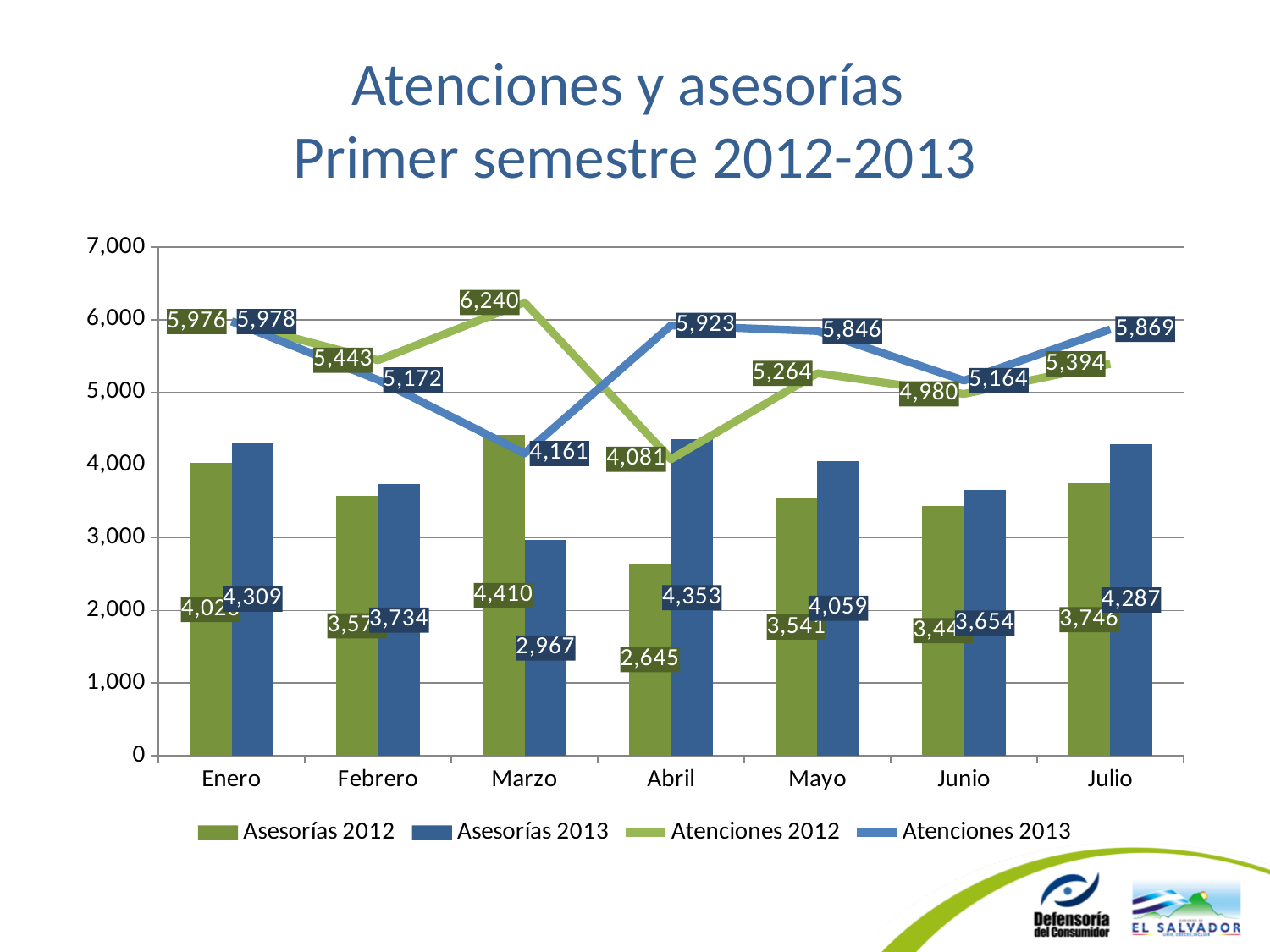
In which month is Asesorías 2013 lowest? Marzo What is the difference between Atenciones 2013 in Abril and in Marzo? 1,762 In which month is Atenciones 2012 lowest? Abril Is the value for Asesorías 2013 in Enero greater or less than 4,000? greater In Marzo, which is larger: Asesorías 2012 or Asesorías 2013? Asesorías 2012 What kind of chart is shown on the slide? Combined bar and line chart In which month is Atenciones 2012 highest? Marzo How many months are shown on the x axis? 7 What is the value of Asesorías 2013 in Abril? 4,353 How many series does the legend list? 4 What is the value of Atenciones 2012 in Marzo? 6,240 What is the value of Atenciones 2013 in Julio? 5,869